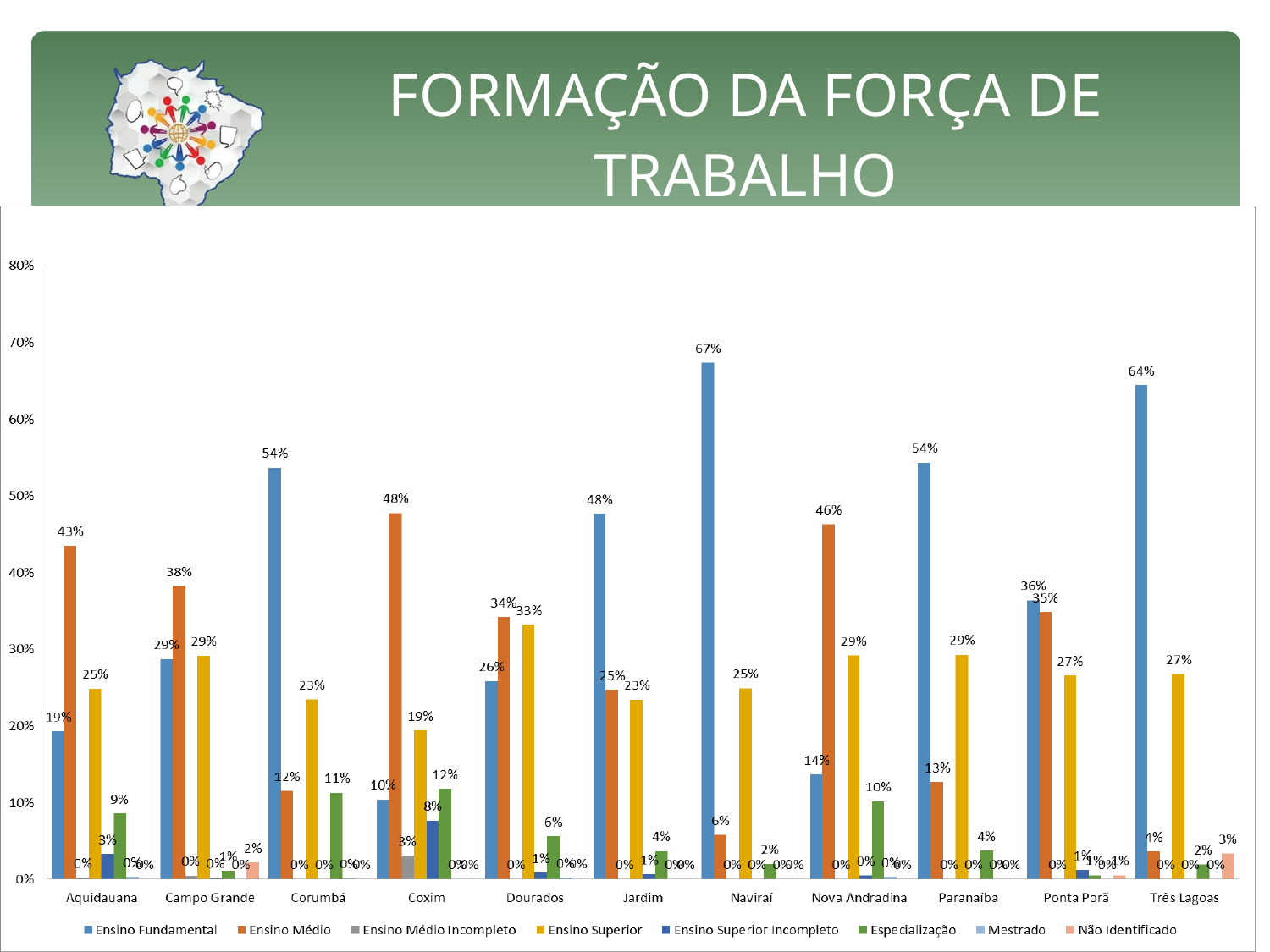
What is the difference between the Ensino Fundamental values for Três Lagoas and Corumbá? 10% What is the Ensino Superior value for Dourados? 33% What type of chart is shown on the slide? bar chart Which municipality has the lowest Ensino Médio value? Três Lagoas Which municipality has the highest Ensino Fundamental value? Naviraí What is the Especialização value for Corumbá? 11% Which is larger for Nova Andradina: Ensino Médio or Ensino Superior? Ensino Médio What is the Ensino Médio value for Coxim? 48% What is the Ensino Fundamental value for Naviraí? 67% How many series does the legend list? 8 How many municipalities (categories) are shown on the x axis? 11 What is the title of the chart on the slide? FORMAÇÃO DA FORÇA DE TRABALHO